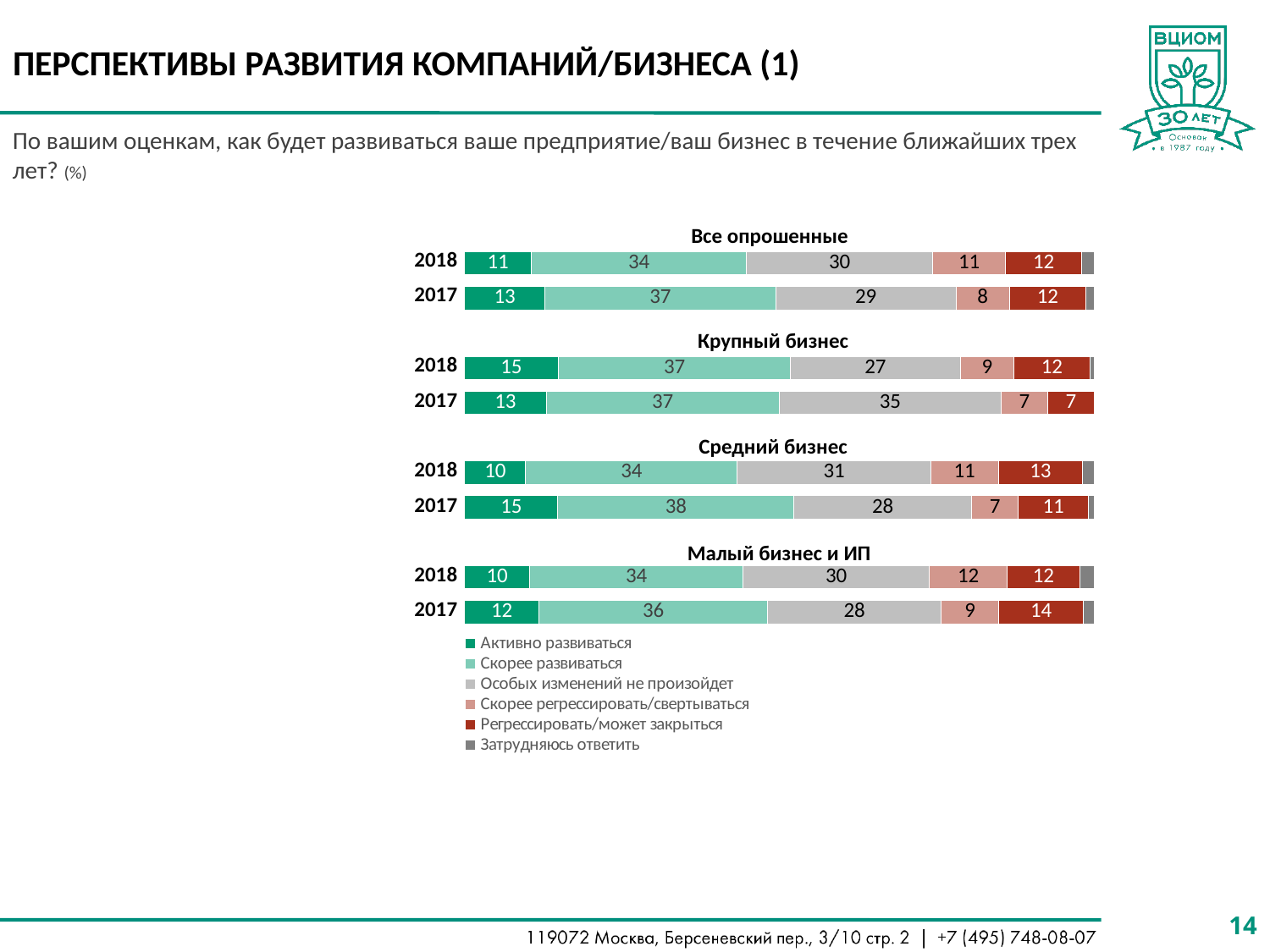
In the "Крупный бизнес" chart, what is the difference between the "Регрессировать/может закрыться" values for 2018 and 2017? 5 In the "Малый бизнес и ИП" chart, what is the value of "Активно развиваться" for 2017? 12 How many series does the legend list? 6 In the "Средний бизнес" chart, what is the difference between the "Активно развиваться" values for 2017 and 2018? 5 In the "Крупный бизнес" chart, what is the value of "Особых изменений не произойдет" for 2017? 35 In the "Все опрошенные" chart, which labelled segment of the 2017 bar is the smallest? Скорее регрессировать/свертываться What kind of chart is used on this slide? Stacked bar chart In the "Все опрошенные" chart, what is the value of "Скорее развиваться" for 2018? 34 In the "Крупный бизнес" chart, which labelled segment of the 2018 bar is the largest? Скорее развиваться In the "Малый бизнес и ИП" chart, is the "Скорее развиваться" value larger for 2018 or 2017? 2017 How many years are compared in each chart on the slide? 2 In the "Средний бизнес" chart, what is the value of "Регрессировать/может закрыться" for 2018? 13